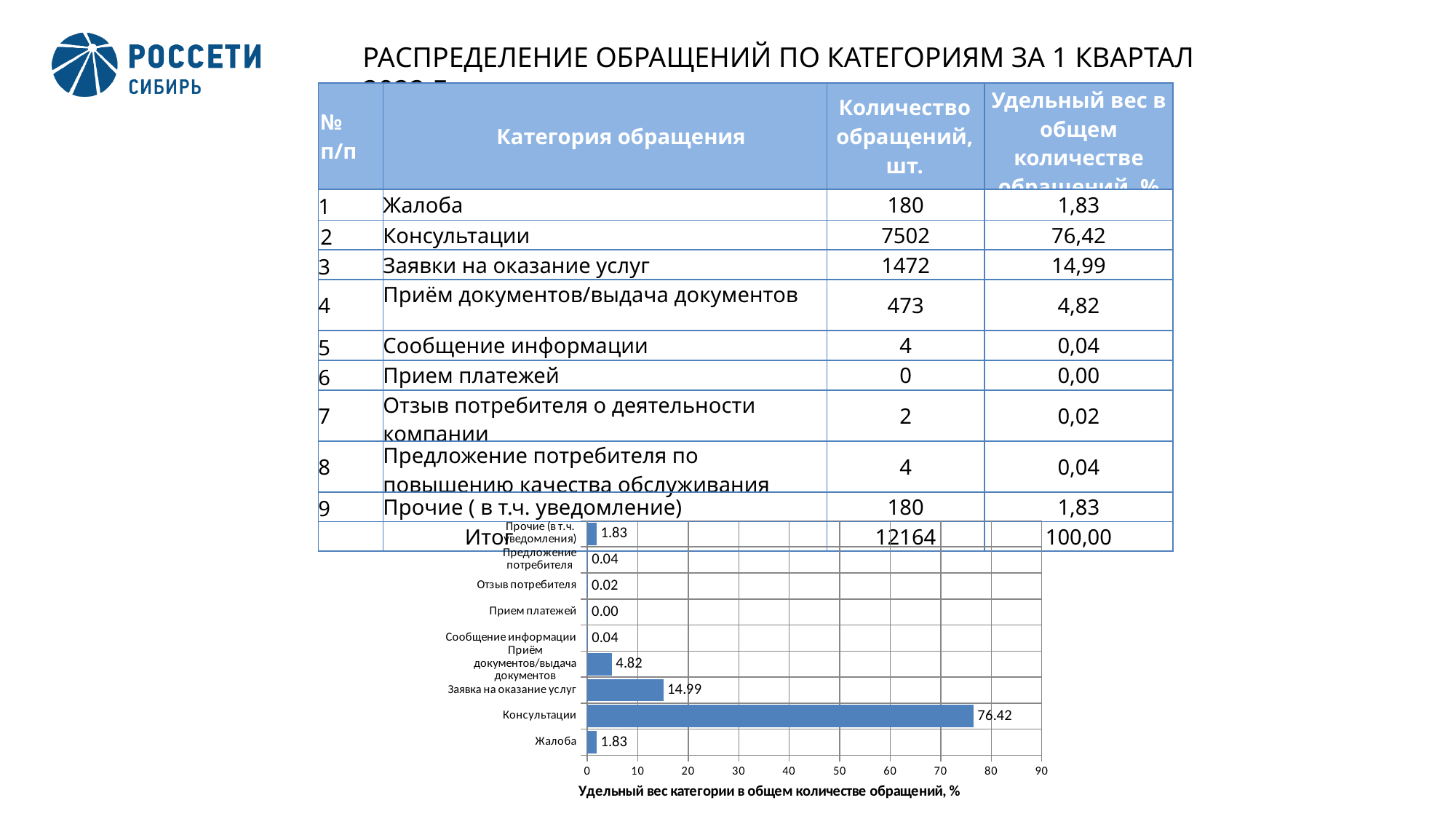
Which category has the highest value in the bar chart? Консультации In the bar chart, what is the value for Жалоба? 1.83 In the bar chart, what is the value for Консультации? 76.42 In the bar chart, what is the value for Заявка на оказание услуг? 14.99 In the bar chart, what is the value for Прием платежей? 0.00 What type of chart is shown on the slide? bar chart What is the x-axis title of the bar chart? Удельный вес категории в общем количестве обращений, % How many categories are shown in the bar chart? 9 In the bar chart, what is the value for Приём документов/выдача документов? 4.82 In the bar chart, what is the difference between the values for Консультации and Заявка на оказание услуг? 61.43 In the bar chart, which is larger: the value for Приём документов/выдача документов or the value for Жалоба? Приём документов/выдача документов Which category has the lowest value in the bar chart? Прием платежей